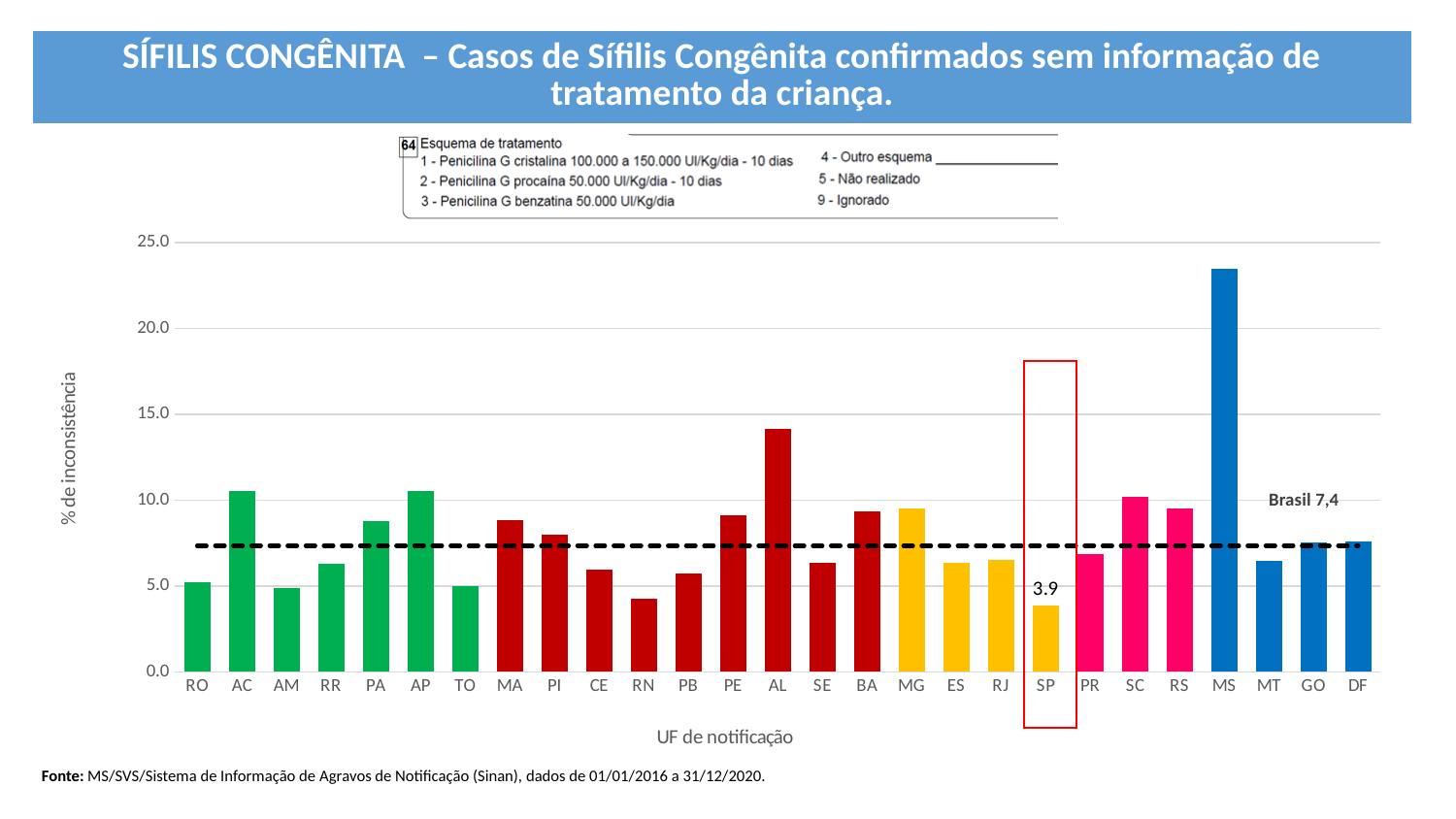
Is the value for SP greater or less than 5.0? less Which UF has the highest value? MS What is the value for SP? 3.9 Which is larger, the value for AC or the value for RO? AC Is the value for RN greater or less than 5.0? less Is the value for AL greater or less than 15.0? less How many UFs (categories) are plotted on the x axis? 27 Which is larger, the value for AL or the value for PE? AL What is the label of the y axis? % de inconsistência What value does the dashed reference line labelled Brasil represent? 7,4 What type of chart is shown on the slide? bar chart